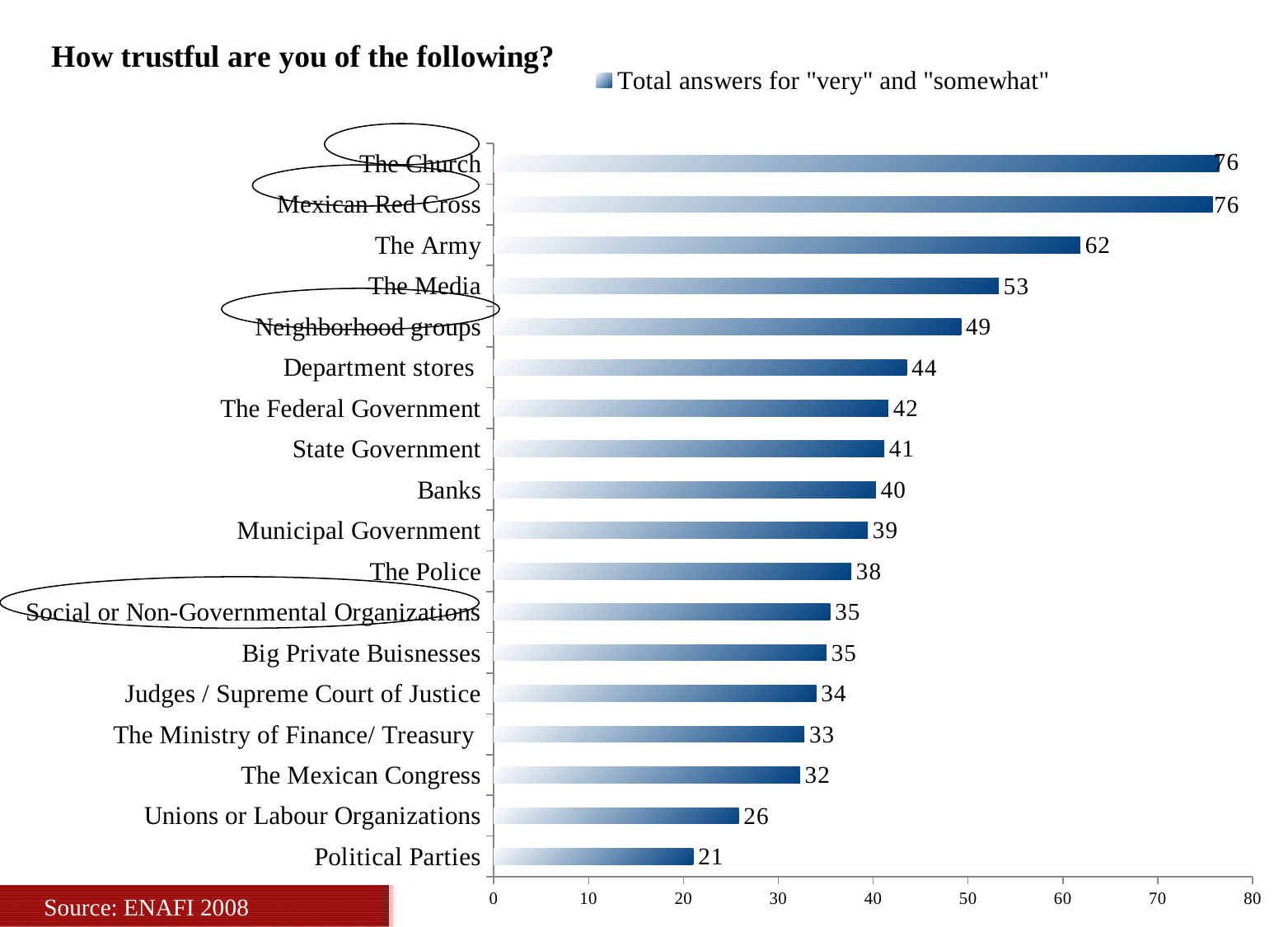
Which category has the lowest value? Political Parties What kind of chart is shown? Bar chart How many categories are shown in the chart? 18 How many series does the legend list? 1 What is the value for Unions or Labour Organizations? 26 What is the legend entry for the series? Total answers for "very" and "somewhat" What is the difference between the values for The Church and Political Parties? 55 What is the difference between the values for The Media and The Police? 15 What is the value for Banks? 40 Which is larger, the value for Department stores or the value for Municipal Government? Department stores Do the values rise or fall going from The Church down to Political Parties? Fall What is the value for The Army? 62